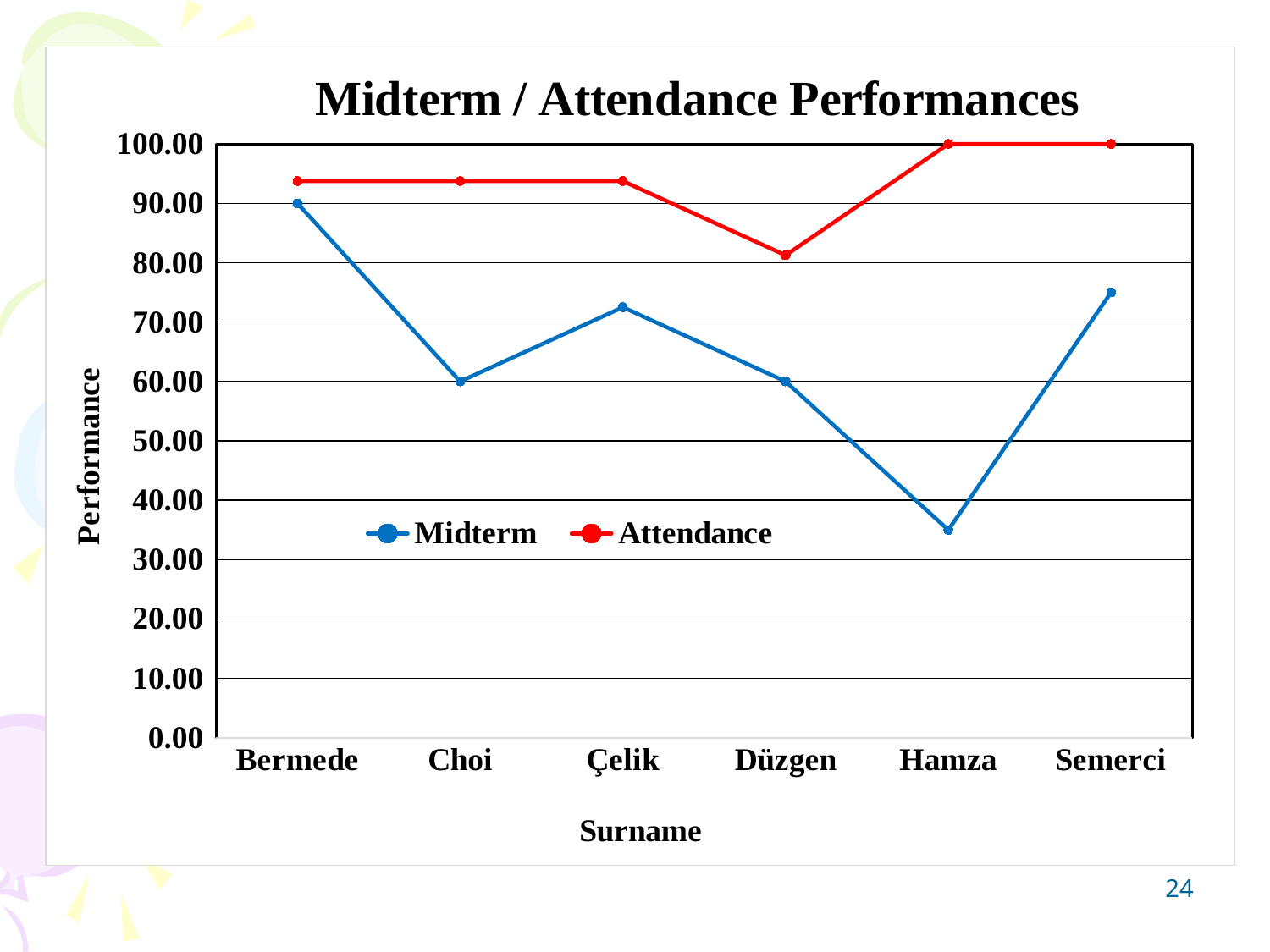
What type of chart is shown on the slide? line chart Is the Midterm value for Çelik greater or less than 70.00? greater Is the Midterm value for Hamza greater or less than 40.00? less Which surname has the lowest Attendance value? Düzgen What is the Midterm value for Bermede? 90.00 What is the Midterm value for Choi? 60.00 How many surnames are plotted along the x axis? 6 Which surname has the lowest Midterm value? Hamza What is the Attendance value for Hamza? 100.00 Which surname has the highest Midterm value? Bermede How many series does the legend list? 2 What is the difference between the Midterm values for Bermede and Choi? 30.00